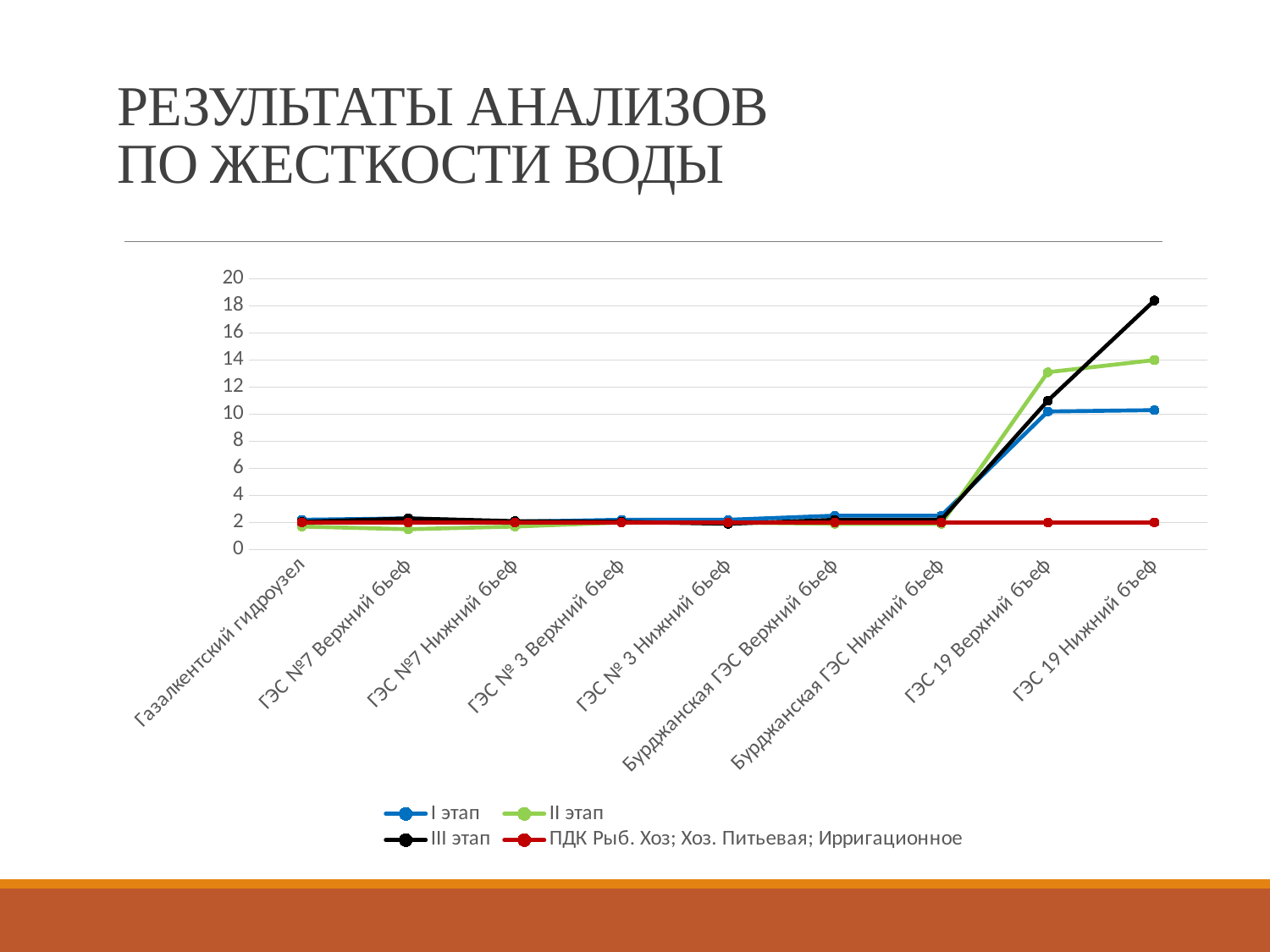
Is the value for II этап at ГЭС 19 Верхний бьеф greater or less than 12? greater How many series does the legend list? 4 What kind of chart is shown on the slide? line chart At ГЭС 19 Верхний бьеф, which is larger: the value for II этап or the value for I этап? II этап How many categories are shown on the x axis? 9 Is the value for III этап at ГЭС 19 Нижний бьеф greater or less than 16? greater At ГЭС 19 Нижний бьеф, which is larger: the value for III этап or the value for I этап? III этап Is the value for I этап at ГЭС 19 Нижний бьеф greater or less than 12? less Do the values for III этап rise or fall from the first category to the last category along the x axis? rise Which category has the highest value for III этап? ГЭС 19 Нижний бъеф What is the title of the slide? РЕЗУЛЬТАТЫ АНАЛИЗОВ ПО ЖЕСТКОСТИ ВОДЫ